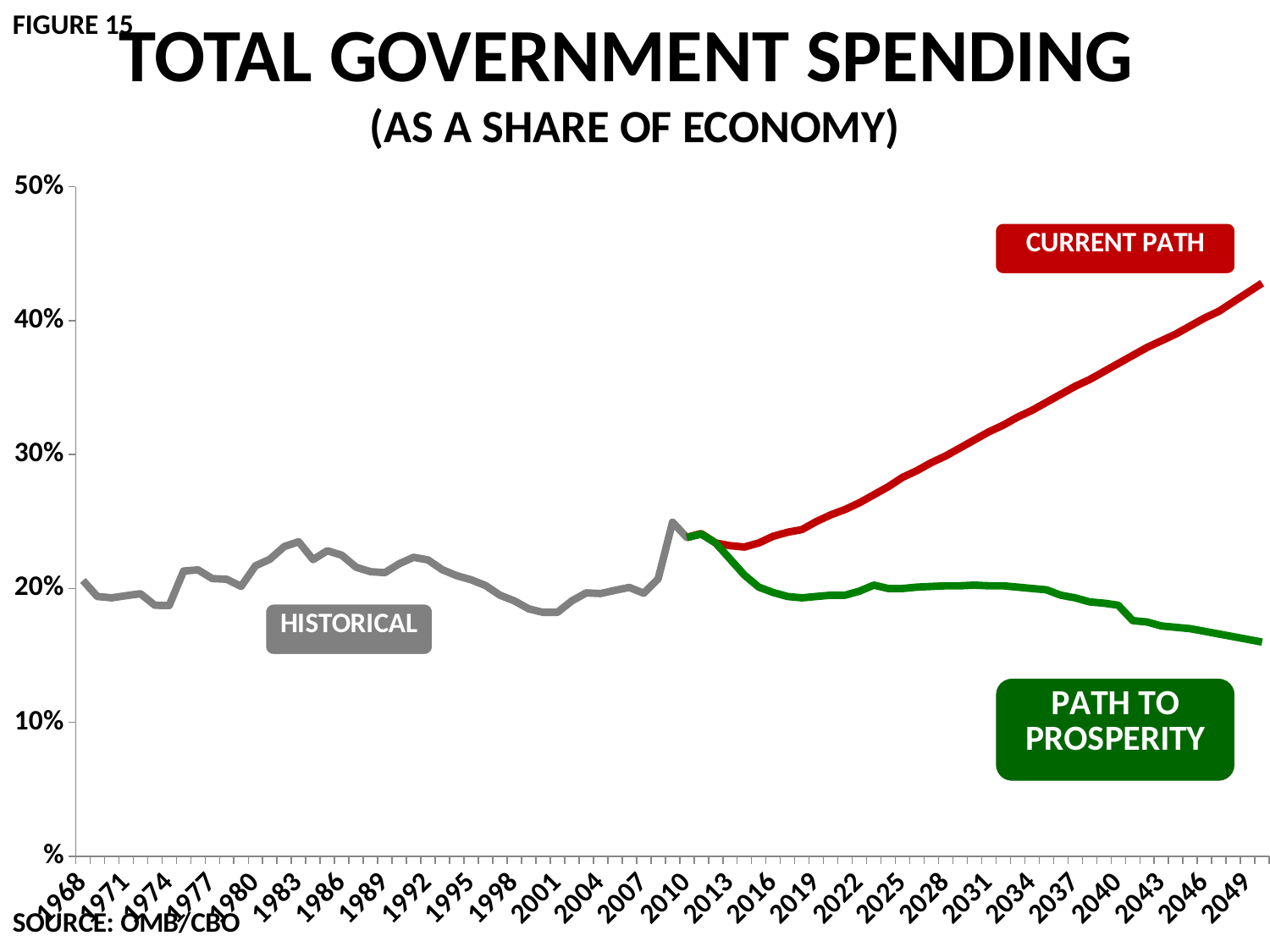
Is the HISTORICAL value in 2001 greater or less than 20%? less What source is cited for the chart? OMB/CBO Is the CURRENT PATH value in 2049 greater or less than 40%? greater Is the CURRENT PATH value in 2031 greater or less than 30%? greater What is the title of the chart? TOTAL GOVERNMENT SPENDING (AS A SHARE OF ECONOMY) In 2049, which line is higher: CURRENT PATH or PATH TO PROSPERITY? CURRENT PATH Does the CURRENT PATH line rise or fall from 2013 to 2049? rise Does the PATH TO PROSPERITY line rise or fall from 2013 to 2049? fall How many labeled series (lines) does the chart show? 3 What kind of chart is shown on the slide? line chart